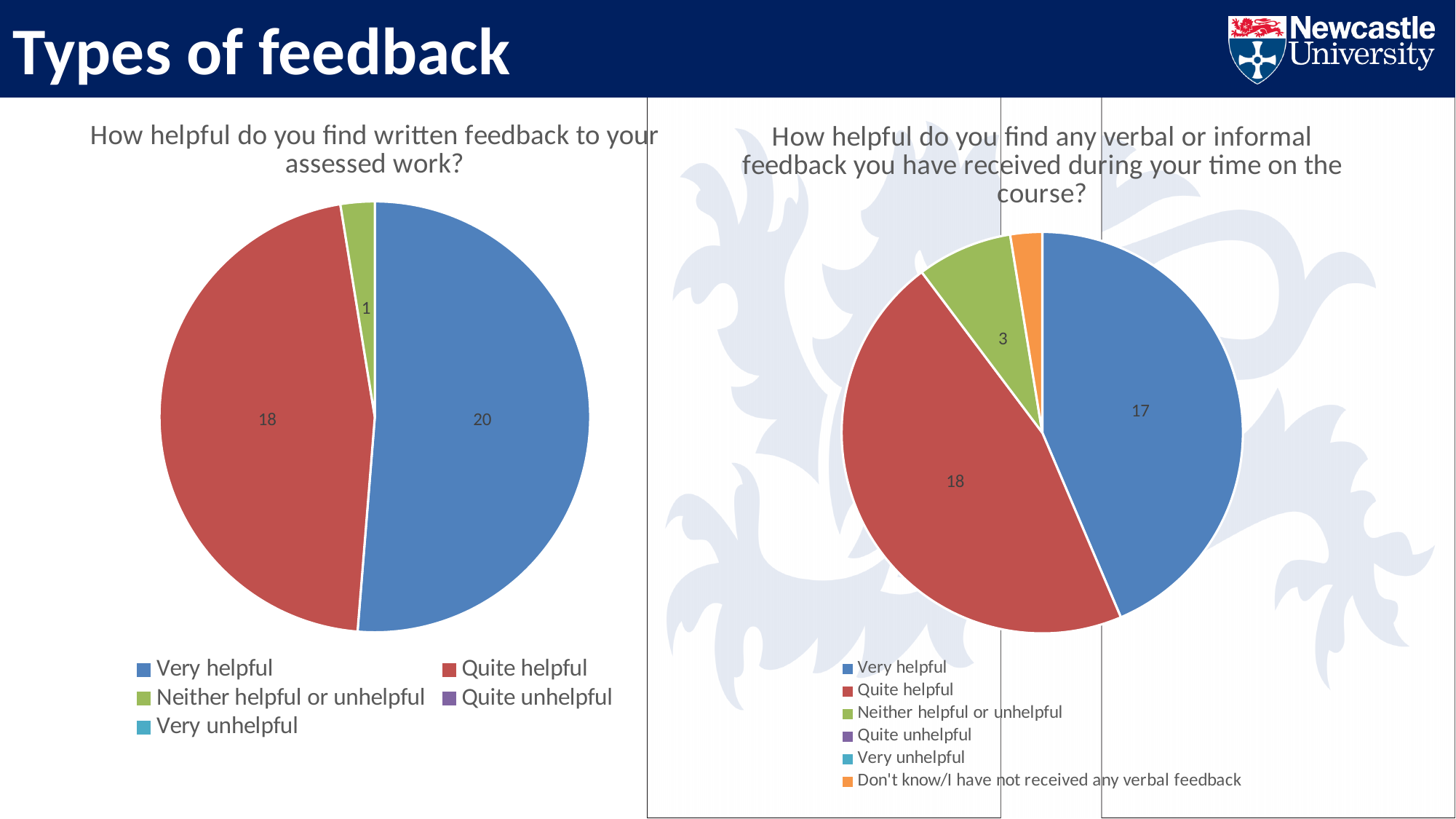
What type of chart is used on the left for written feedback? Pie chart On the right chart (verbal or informal feedback), what is the value for 'Neither helpful or unhelpful'? 3 On the left chart (written feedback), which category has the largest slice? Very helpful On the left chart (written feedback), how many respondents said 'Very helpful'? 20 On the left chart (written feedback), what is the value for 'Neither helpful or unhelpful'? 1 How many entries does the legend of the right chart (verbal or informal feedback) list? 6 On the left chart (written feedback), what is the value for 'Quite helpful'? 18 On the right chart (verbal or informal feedback), which is larger: 'Very helpful' or 'Quite helpful'? Quite helpful On the left chart (written feedback), what is the difference between 'Very helpful' and 'Quite helpful'? 2 On the right chart (verbal or informal feedback), what is the value for 'Very helpful'? 17 On the left chart (written feedback), what is the total of the three labelled slices? 39 On the right chart (verbal or informal feedback), what is the value for 'Quite helpful'? 18